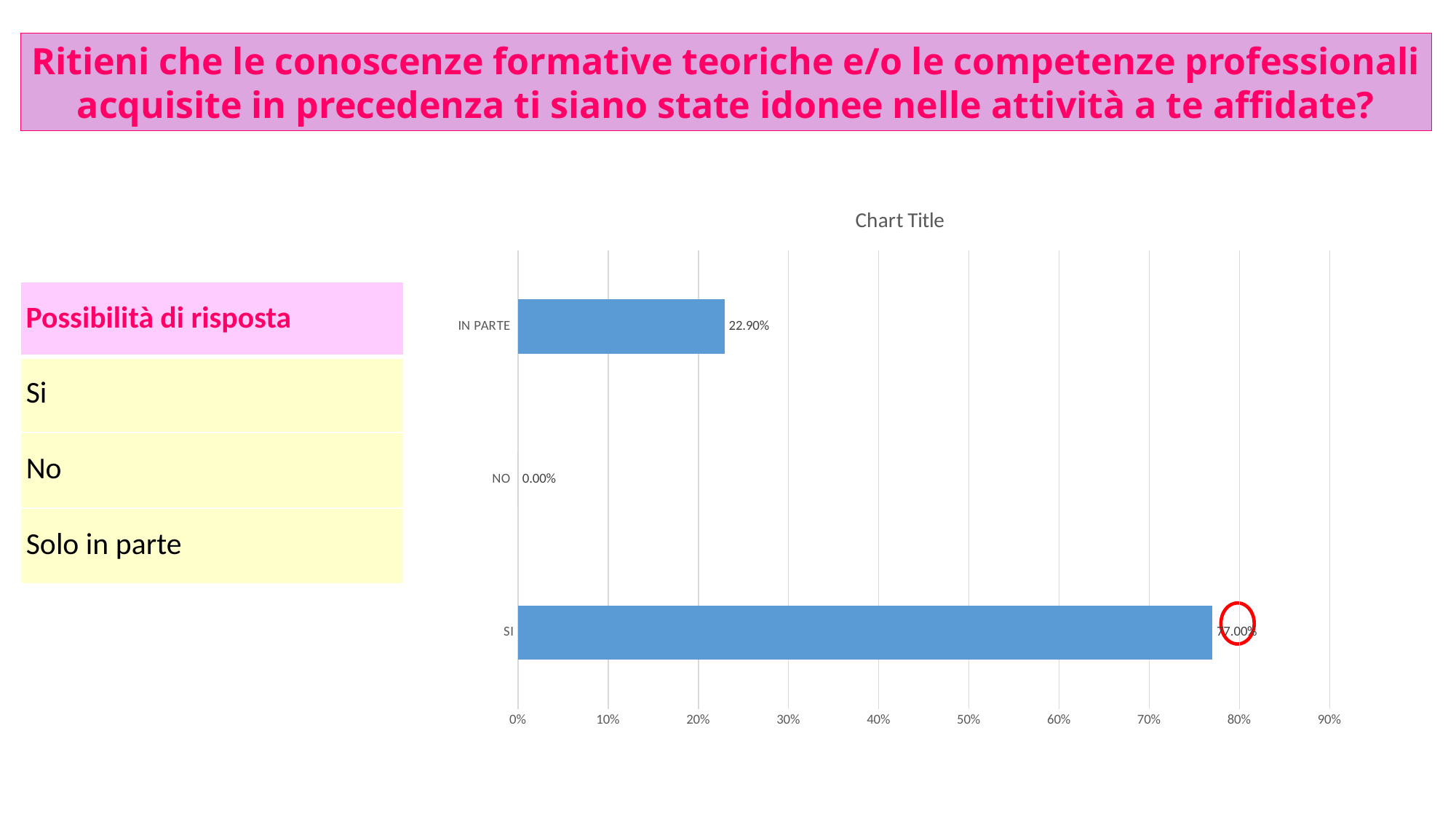
What is the value for NO? 0.00% What kind of chart is shown on the slide? bar chart Which category has the lowest value? NO How many categories are shown in the chart? 3 Is the value for IN PARTE greater or less than 30%? less What is the value for SI? 77.00% Which category has the highest value? SI Is the value for SI greater or less than 70%? greater What is the value for IN PARTE? 22.90% Which is larger, the value for SI or the value for IN PARTE? SI What is the difference between the values for SI and IN PARTE? 54.10% What is the title of the chart? Chart Title